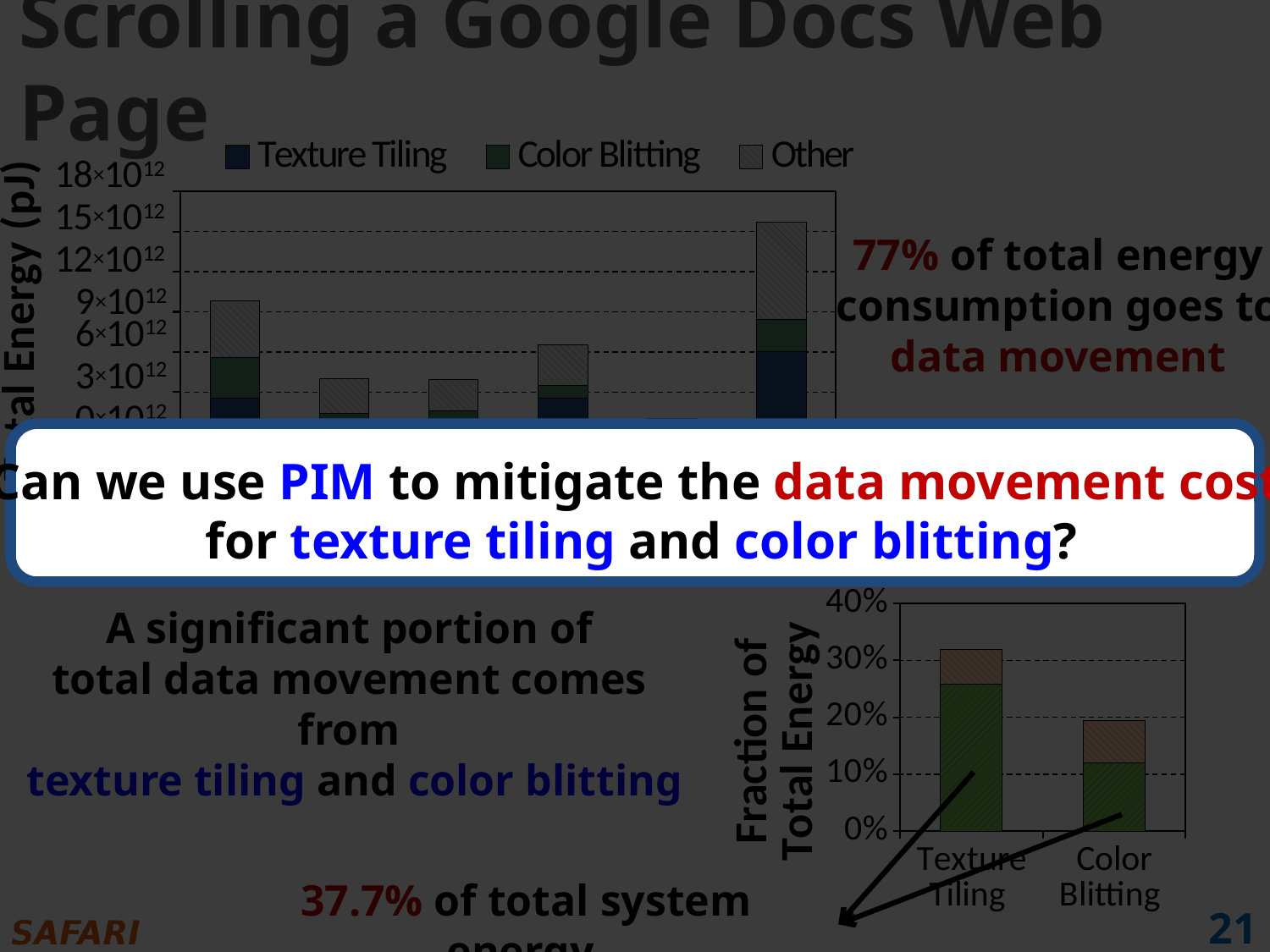
In the top chart, what are the three legend entries? Texture Tiling, Color Blitting, Other In the bottom chart (Fraction of Total Energy), is the value for Color Blitting greater or less than 10%? greater In the bottom chart (Fraction of Total Energy), how many categories are shown on the x axis? 2 In the top chart, is the total of the rightmost bar greater or less than 12×10^12? greater In the top chart, which bar is the tallest? The rightmost bar In the top chart, is the total of the leftmost bar greater or less than 6×10^12? greater In the top chart, how many bars are plotted? 6 In the bottom chart (Fraction of Total Energy), which category has the larger value, Texture Tiling or Color Blitting? Texture Tiling What kind of chart is the top chart? Stacked bar chart In the top chart, how many series does the legend list? 3 What is the y-axis title of the bottom chart? Fraction of Total Energy